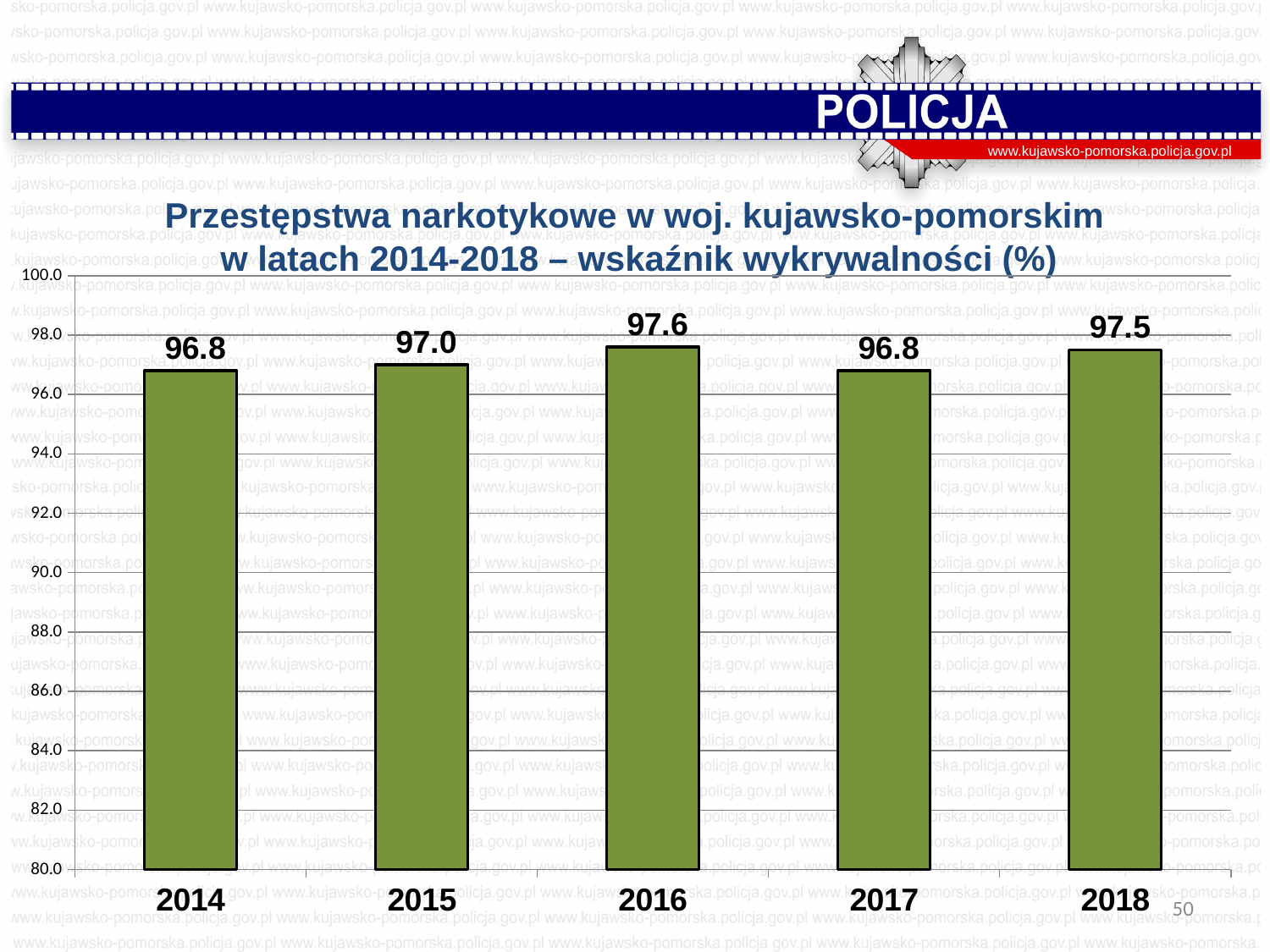
What value is shown for 2014? 96.8 What is the detection rate (wskaźnik wykrywalności) shown for 2016? 97.6 How many years are shown on the chart? 5 What is the difference between the values for 2016 and 2014? 0.8 What value is shown for 2018? 97.5 What value is shown for 2015? 97.0 Which year has the larger value, 2015 or 2016? 2016 Do the values rise or fall from 2014 to 2016? rise What kind of chart is shown on the slide? bar chart What is the lowest value shown on the chart? 96.8 Is the value for 2017 greater or less than 98.0? less Which year has the highest detection rate? 2016